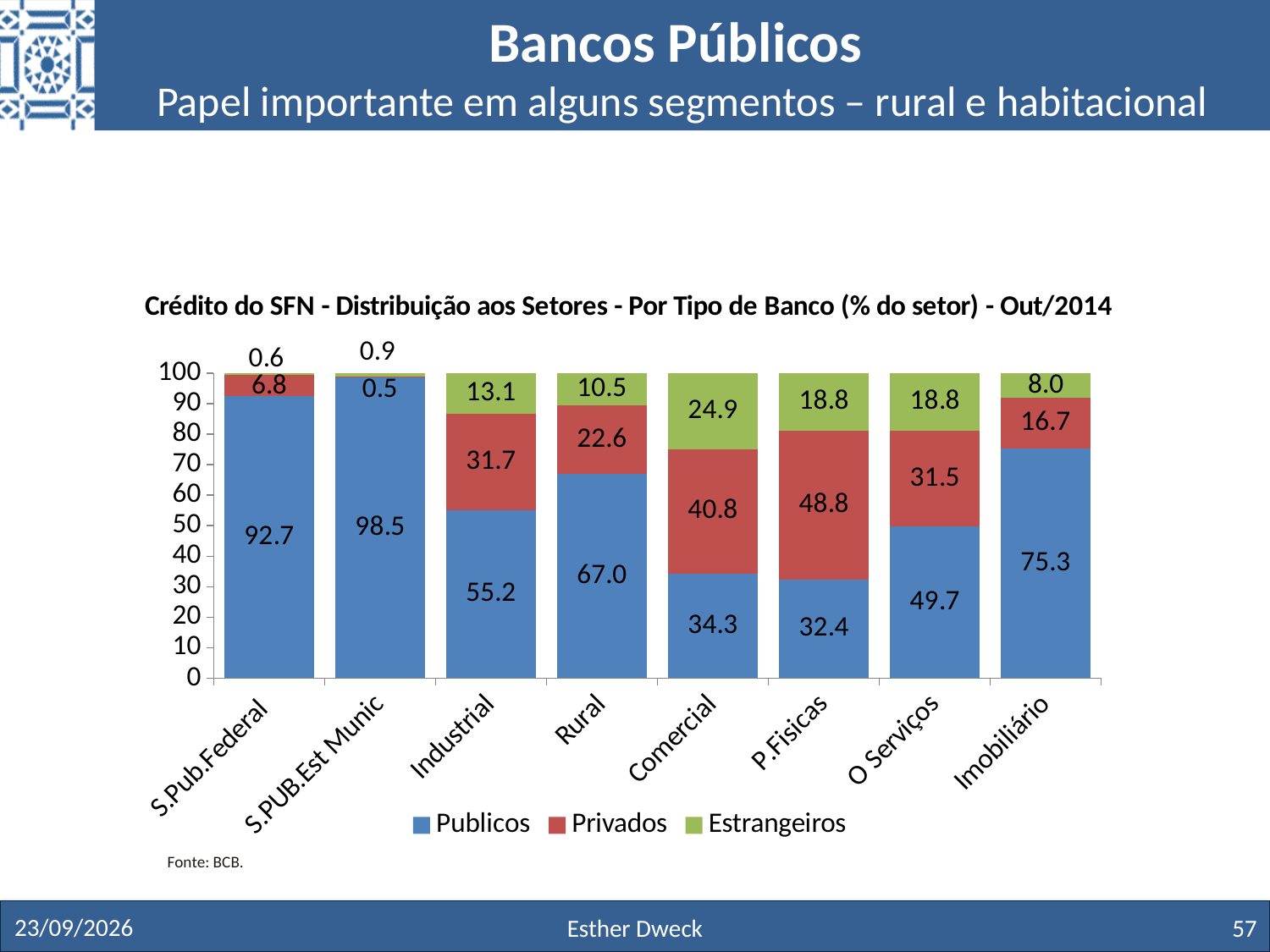
Which category has the highest Publicos value? S.PUB.Est Munic What is the Publicos value for Imobiliário? 75.3 What is the Publicos value for Rural? 67.0 How many series does the legend list? 3 What is the Privados value for P.Fisicas? 48.8 Which category has the lowest Publicos value? P.Fisicas What is the Estrangeiros value for Comercial? 24.9 What is the difference between the Privados values for Comercial and Industrial? 9.1 How many categories are shown on the x axis? 8 What kind of chart is shown on the slide? Stacked bar chart Which is larger, the Estrangeiros value for Industrial or for Rural? Industrial What is the source cited below the chart? BCB